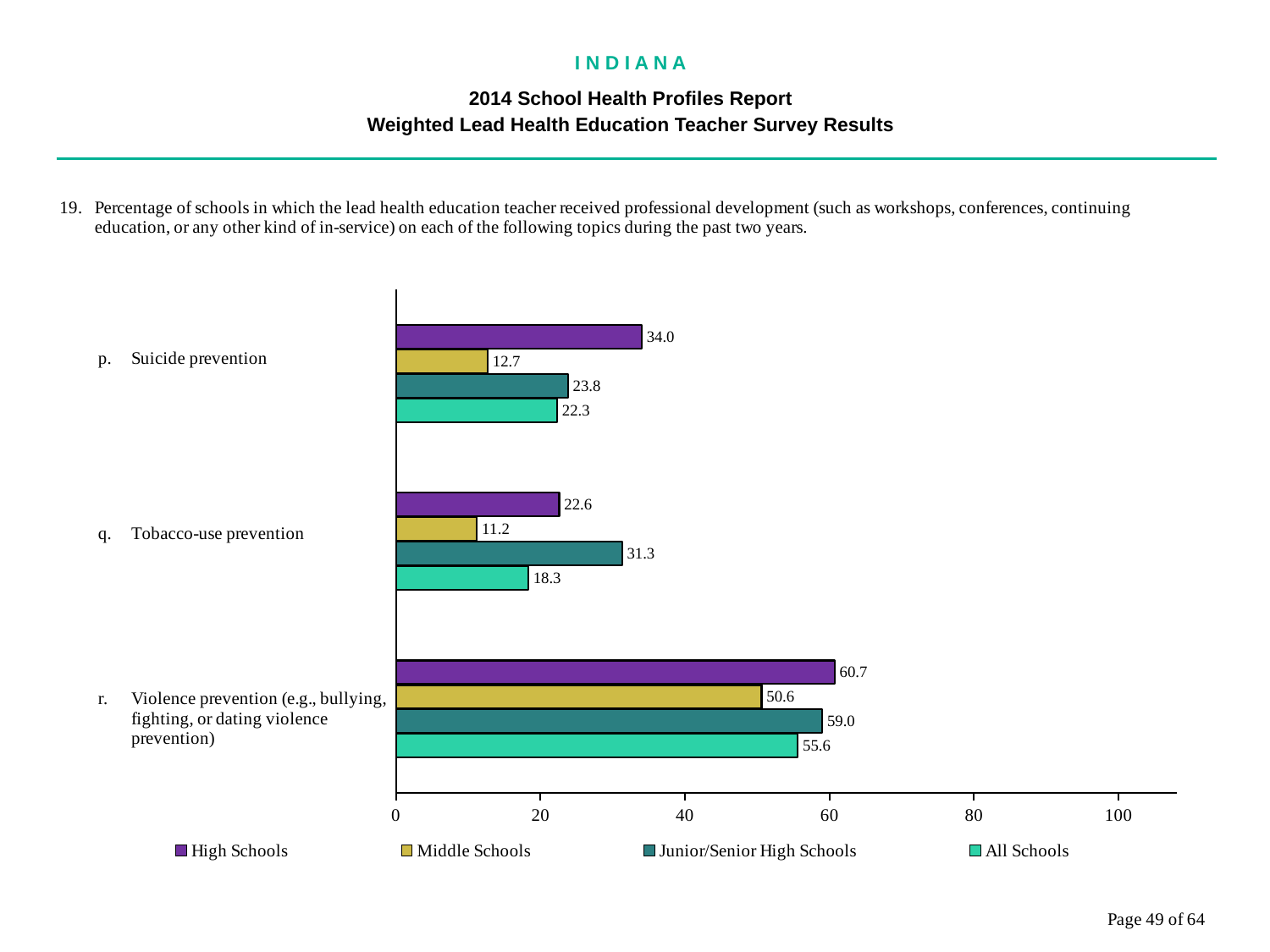
What is the value for High Schools for Suicide prevention? 34.0 How many topics (categories) are shown on the chart? 3 What is the value for All Schools for Violence prevention? 55.6 Is the value for High Schools for Violence prevention greater or less than 60? greater What kind of chart is shown on the slide? Bar chart What is the value for Junior/Senior High Schools for Tobacco-use prevention? 31.3 How many series does the legend list? 4 Which is larger for Tobacco-use prevention: the High Schools value or the Junior/Senior High Schools value? Junior/Senior High Schools Which school type has the lowest value for Suicide prevention? Middle Schools Which school type has the highest value for Violence prevention? High Schools What is the value for Middle Schools for Tobacco-use prevention? 11.2 What is the difference between the High Schools and Middle Schools values for Violence prevention? 10.1